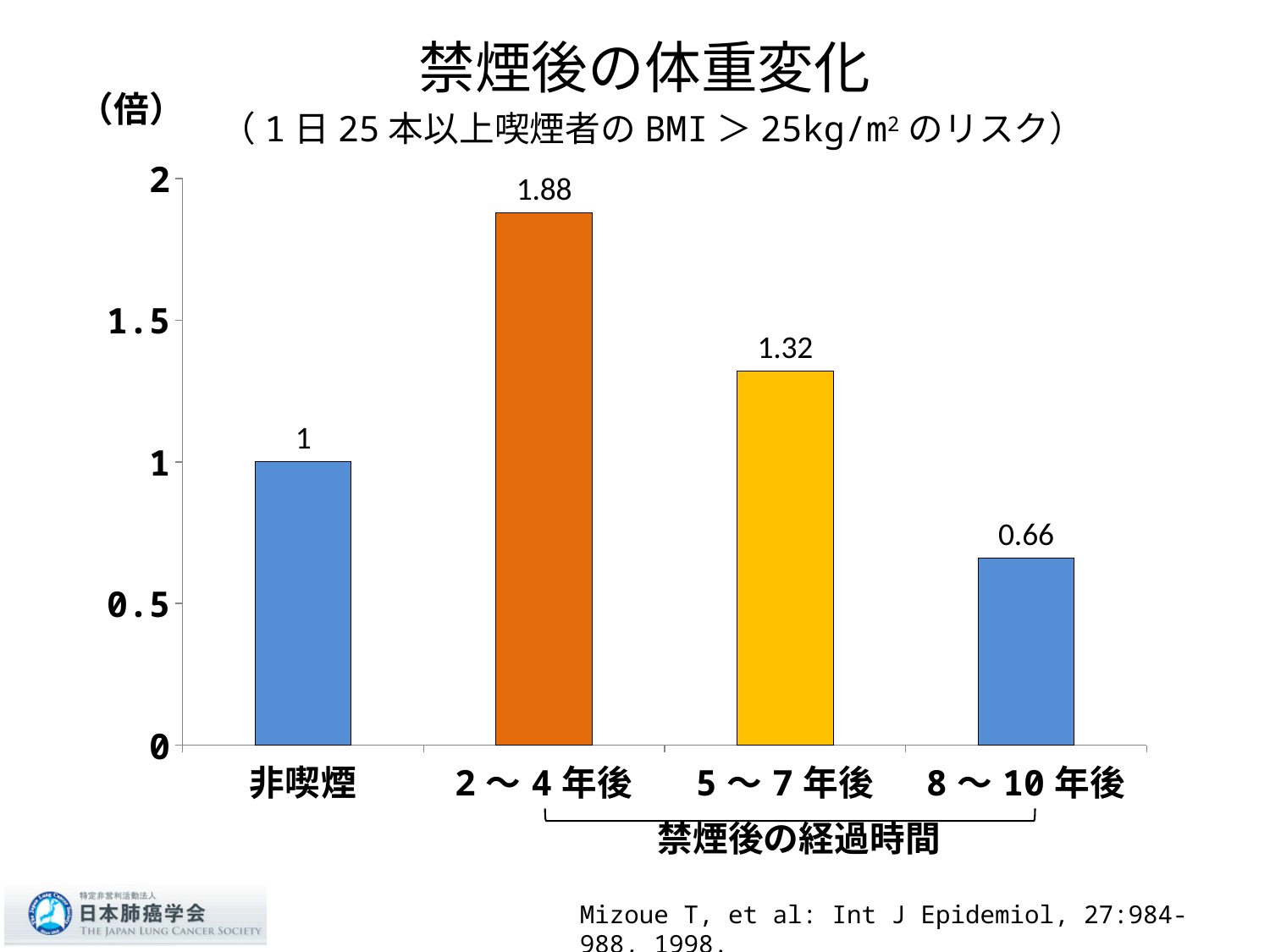
Is the value for 8～10年後 greater or less than 1? less What is the difference between the values for 2～4年後 and 5～7年後? 0.56 How many categories are shown on the x axis? 4 Which is larger, the value for 5～7年後 or the value for 非喫煙? 5～7年後 Which category has the highest value? 2～4年後 What is the value for 非喫煙? 1 Which category has the lowest value? 8～10年後 What kind of chart is shown on the slide? bar chart What is the value for 5～7年後? 1.32 What is the value for 8～10年後? 0.66 What is the title of the chart? 禁煙後の体重変化 What is the value for 2～4年後? 1.88